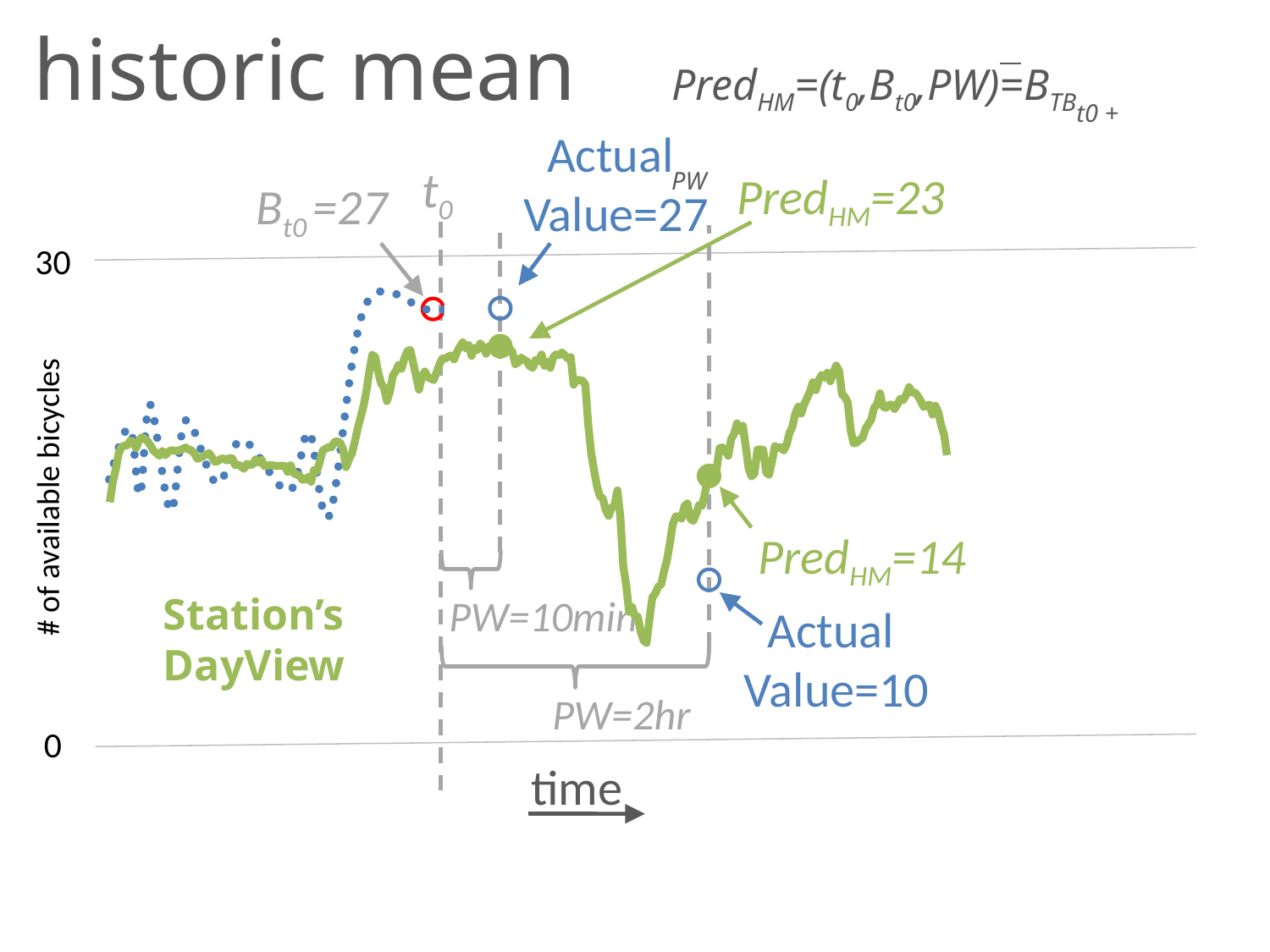
What is the historic mean prediction (Pred_HM) for the 2-hour prediction window? 14 What kind of chart is shown on the slide? Line chart By how much does the actual value exceed Pred_HM for the 10-minute window? 4 What is the actual value at the end of the 2-hour prediction window? 10 For the 2-hour window, which is larger: Pred_HM or the actual value? Pred_HM What are the two prediction window (PW) lengths shown on the chart? 10min and 2hr What is the historic mean prediction (Pred_HM) for the 10-minute prediction window? 23 What is the actual value at the end of the 10-minute prediction window? 27 What is the label of the y-axis? # of available bicycles By how much does Pred_HM exceed the actual value for the 2-hour window? 4 What does the green line represent, according to its label? Station's DayView What is the value of B_t0 marked at time t0? 27